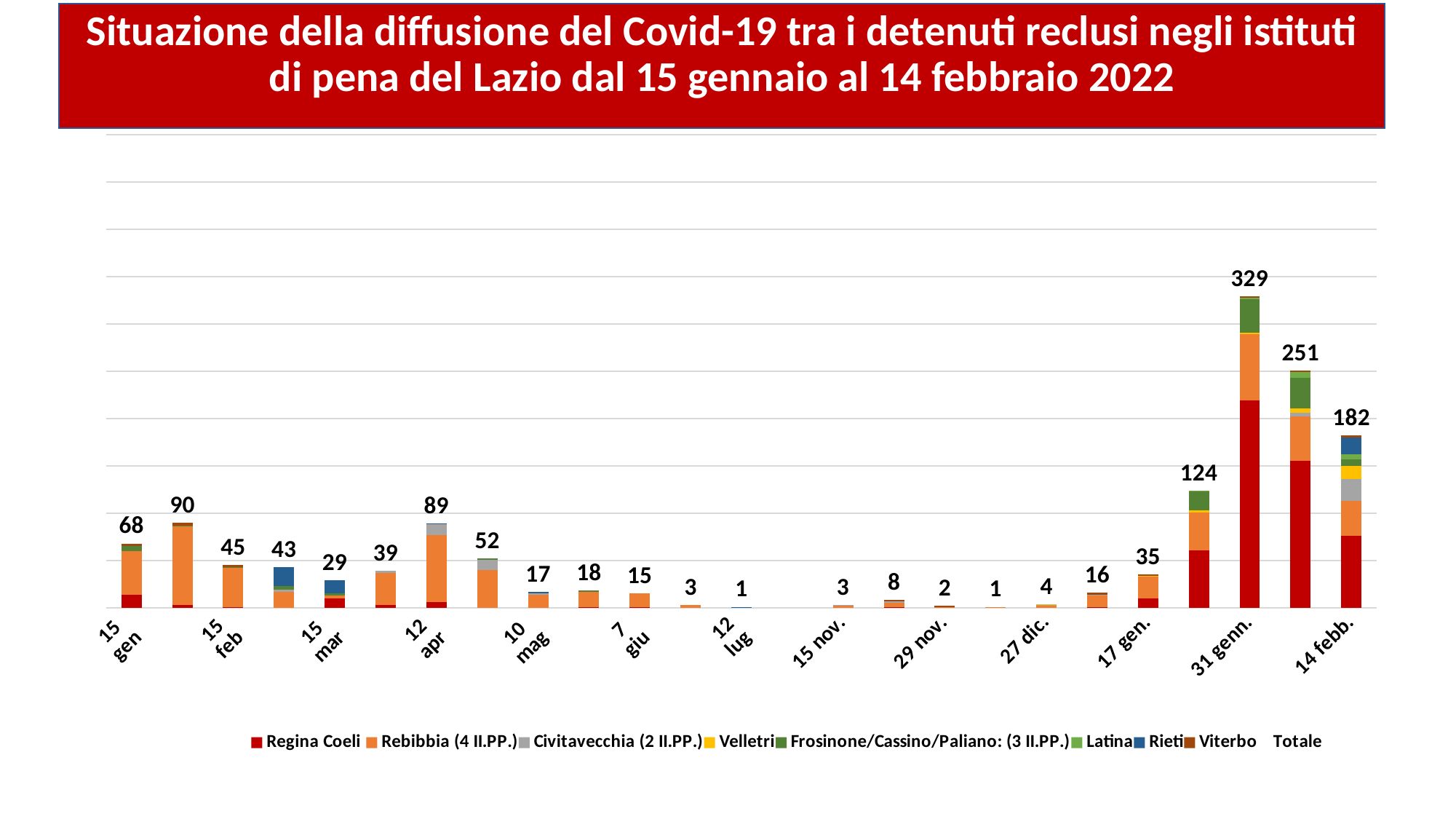
What is the lowest total value labelled on the chart? 1 What kind of chart is shown on the slide? Stacked bar chart What is the total value shown for 12 apr? 89 What is the total value shown for 15 gen? 68 How many entries does the legend list? 9 Which is larger, the total for 31 genn. or the total for 14 febb.? 31 genn. Which date has the highest total value? 31 genn. What is the difference between the totals for 31 genn. and 14 febb.? 147 What is the total value shown for 31 genn.? 329 What is the highest total value labelled on the chart? 329 Which colour represents Regina Coeli in the legend? Red What is the total value shown for 14 febb.? 182